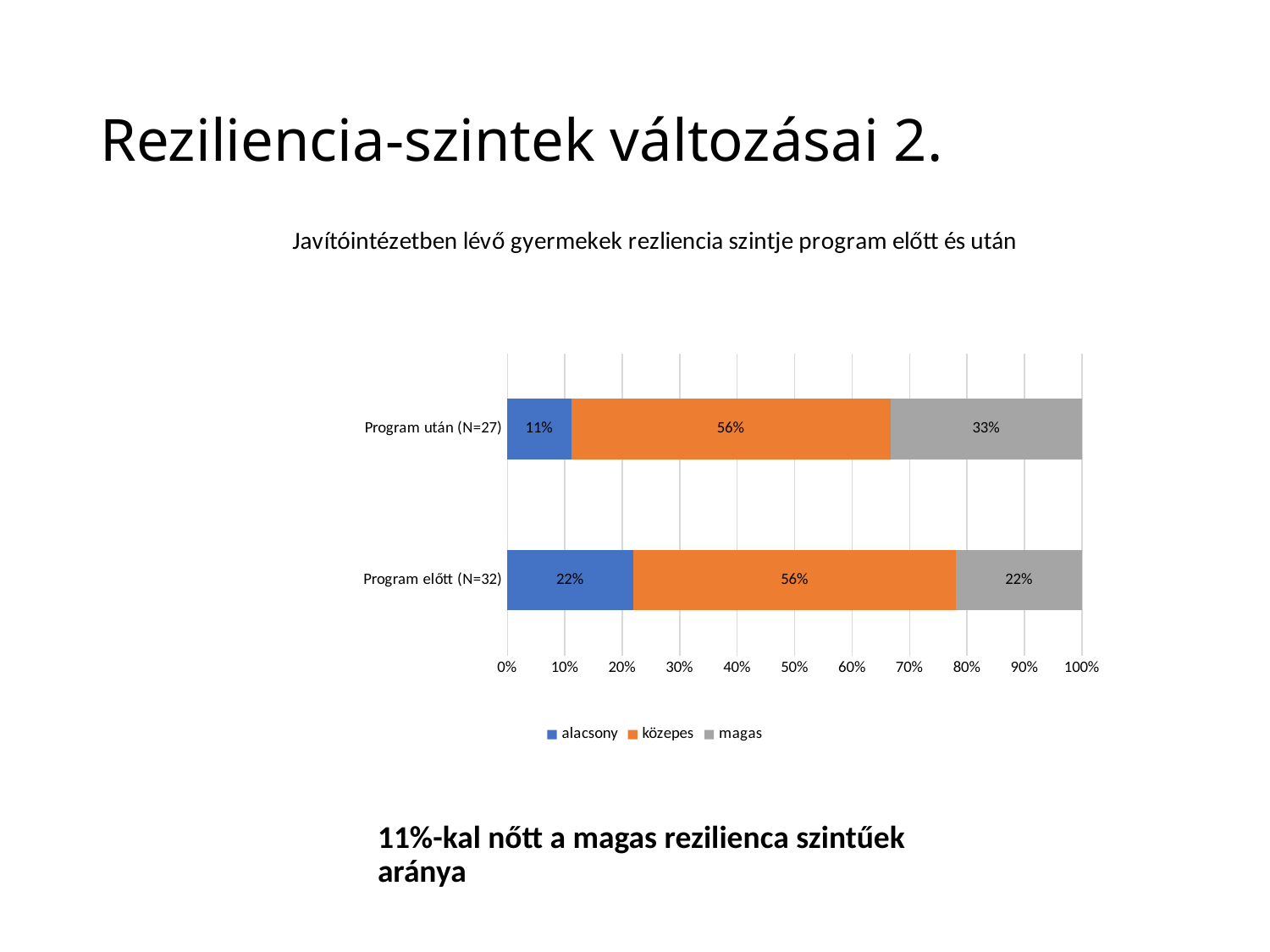
What is the difference between the 'alacsony' values for 'Program előtt (N=32)' and 'Program után (N=27)'? 11% What is the title of the chart? Javítóintézetben lévő gyermekek rezliencia szintje program előtt és után What kind of chart is shown on the slide? Stacked bar chart What is the difference between the 'magas' values for 'Program után (N=27)' and 'Program előtt (N=32)'? 11% How many categories are shown on the chart? 2 What is the value for 'alacsony' in the 'Program előtt (N=32)' bar? 22% Which category has the lower 'alacsony' value? Program után (N=27) What is the value for 'közepes' in the 'Program után (N=27)' bar? 56% Which category has the higher 'magas' value, 'Program előtt (N=32)' or 'Program után (N=27)'? Program után (N=27) What is the value for 'magas' in the 'Program előtt (N=32)' bar? 22% How many series does the legend list? 3 What is the value for 'magas' in the 'Program után (N=27)' bar? 33%